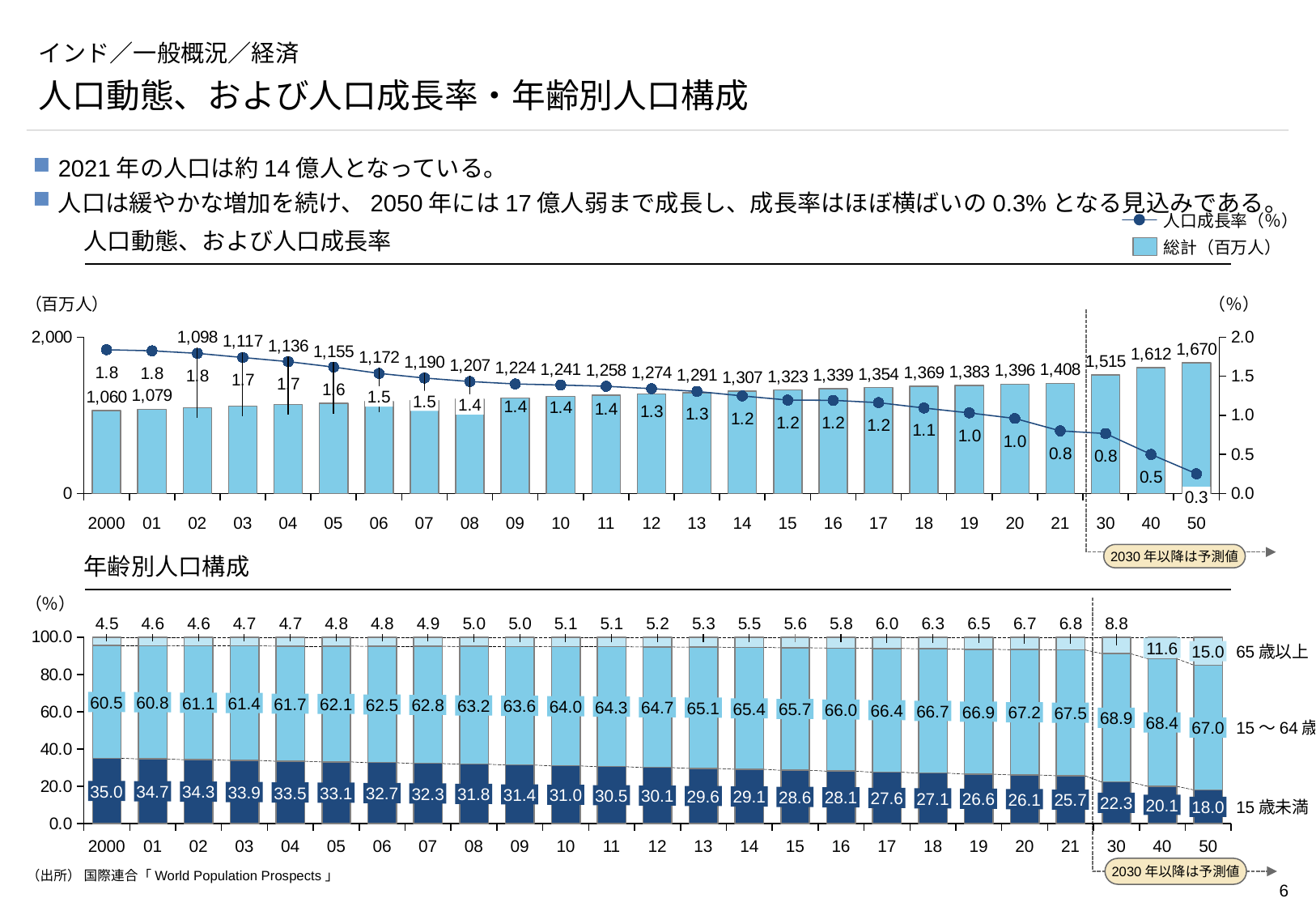
In the top chart (人口動態、および人口成長率), does the 人口成長率 line rise or fall from 2000 to 2050? fall In the bottom chart (年齢別人口構成), which year has the larger 15～64歳 value, 2000 or 2021? 2021 In the bottom chart (年齢別人口構成), what is the 65歳以上 value for 2050? 15.0 In the top chart (人口動態、および人口成長率), how many series does the legend list? 2 In the top chart (人口動態、および人口成長率), which year has the highest 総計 value? 2050 In the bottom chart (年齢別人口構成), what is the 15歳未満 value for 2000? 35.0 In the top chart (人口動態、および人口成長率), how many years are shown on the x axis? 25 In the bottom chart (年齢別人口構成), what is the total of the three segments for 2050? 100.0 In the top chart (人口動態、および人口成長率), what is the 人口成長率 (%) value for 2050? 0.3 In the top chart (人口動態、および人口成長率), what is the difference between the 総計 values for 2050 and 2000? 610 In the top chart (人口動態、および人口成長率), what is the 総計 (百万人) value for 2021? 1,408 What kind of chart is the bottom chart (年齢別人口構成)? stacked bar chart